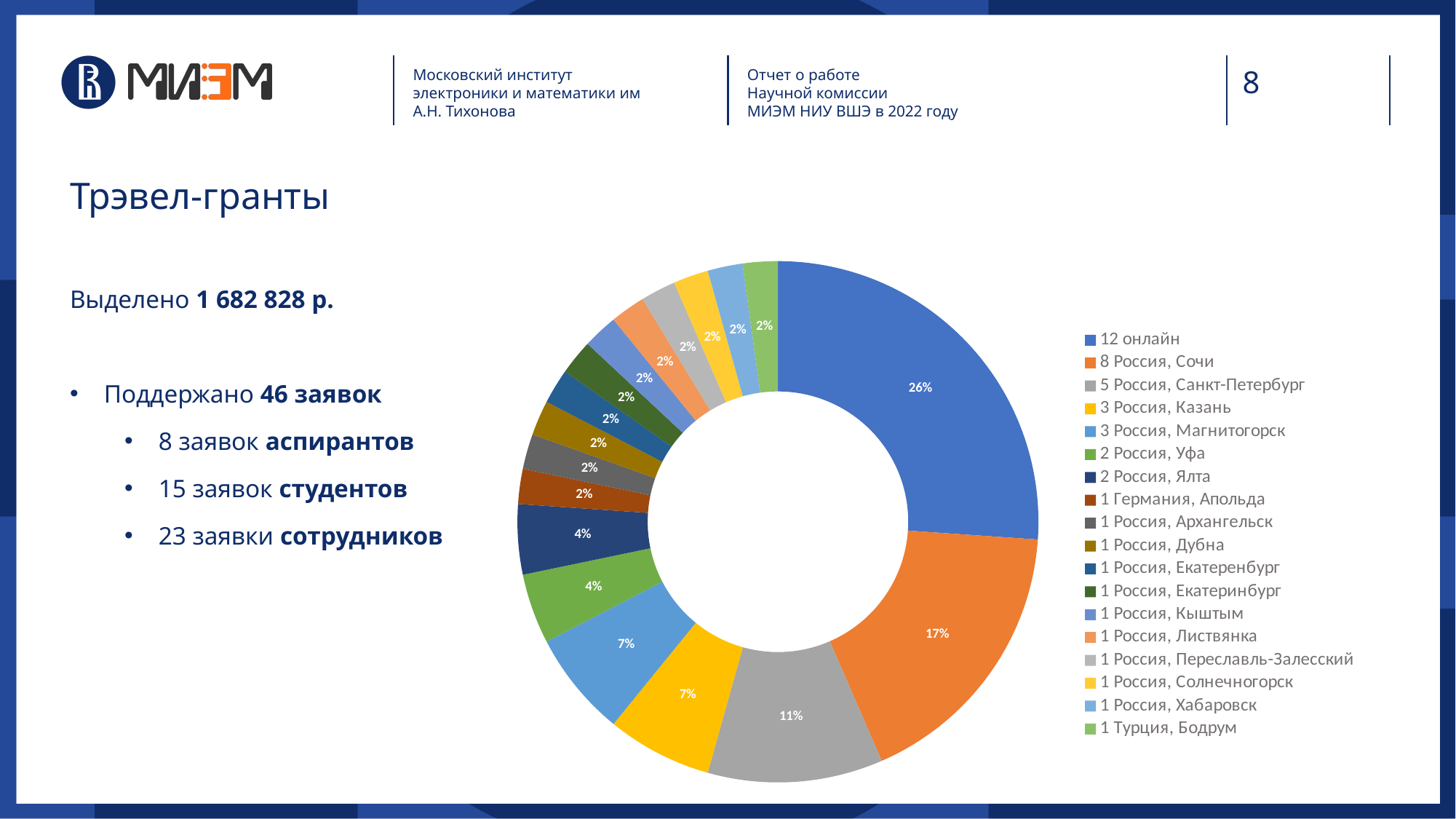
How many categories does the legend of the chart list? 18 By how many percentage points does the "12 онлайн" slice exceed the "8 Россия, Сочи" slice? 9 percentage points What kind of chart is shown on the slide? Doughnut chart Which category has the largest slice in the chart? 12 онлайн What percentage is shown for the "8 Россия, Сочи" slice? 17% What share of the chart does the "12 онлайн" slice represent? 26% Which slice is larger: "8 Россия, Сочи" or "5 Россия, Санкт-Петербург"? 8 Россия, Сочи What percentage is shown for the "1 Турция, Бодрум" slice? 2% What percentage is shown for the "2 Россия, Уфа" slice? 4% What colour is the largest slice of the chart? Blue What is the difference in percentage points between the "8 Россия, Сочи" and "5 Россия, Санкт-Петербург" slices? 6 percentage points What percentage is shown for the "5 Россия, Санкт-Петербург" slice? 11%